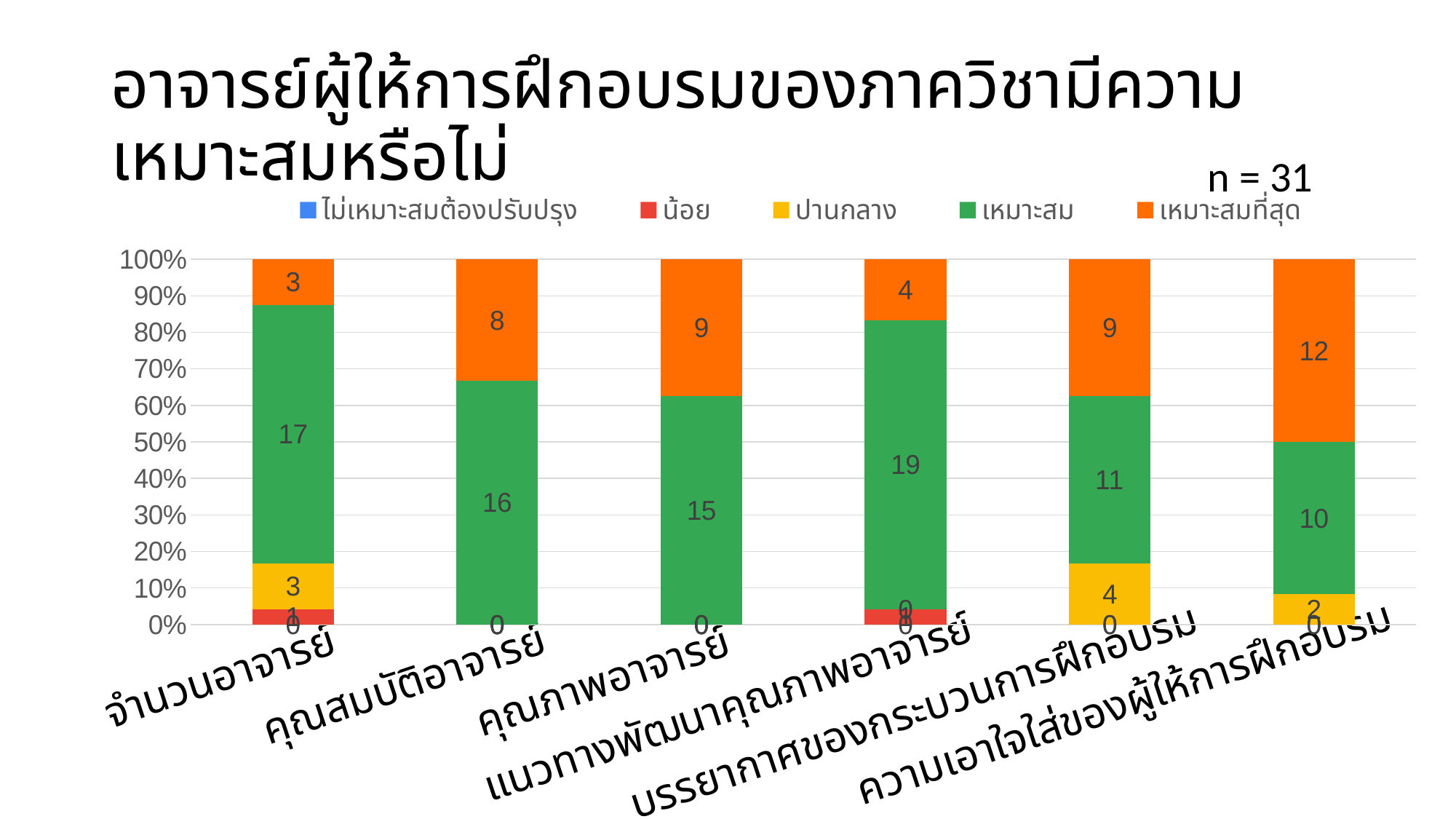
Which category has the highest value for เหมาะสม? แนวทางพัฒนาคุณภาพอาจารย์ What sample size is noted on the slide? n = 31 What is the value of เหมาะสมที่สุด for ความเอาใจใส่ของผู้ให้การฝึกอบรม? 12 What kind of chart is shown on the slide? Stacked bar chart How many categories are shown on the x axis? 6 How many series does the legend list? 5 For คุณภาพอาจารย์, what is the difference between the เหมาะสม value and the เหมาะสมที่สุด value? 6 What is the value of เหมาะสมที่สุด for คุณสมบัติอาจารย์? 8 What is the value of เหมาะสม for จำนวนอาจารย์? 17 Which category has the lowest value for เหมาะสมที่สุด? จำนวนอาจารย์ What is the value of ปานกลาง for บรรยากาศของกระบวนการฝึกอบรม? 4 Which is larger: the เหมาะสม value for คุณสมบัติอาจารย์ or for คุณภาพอาจารย์? คุณสมบัติอาจารย์